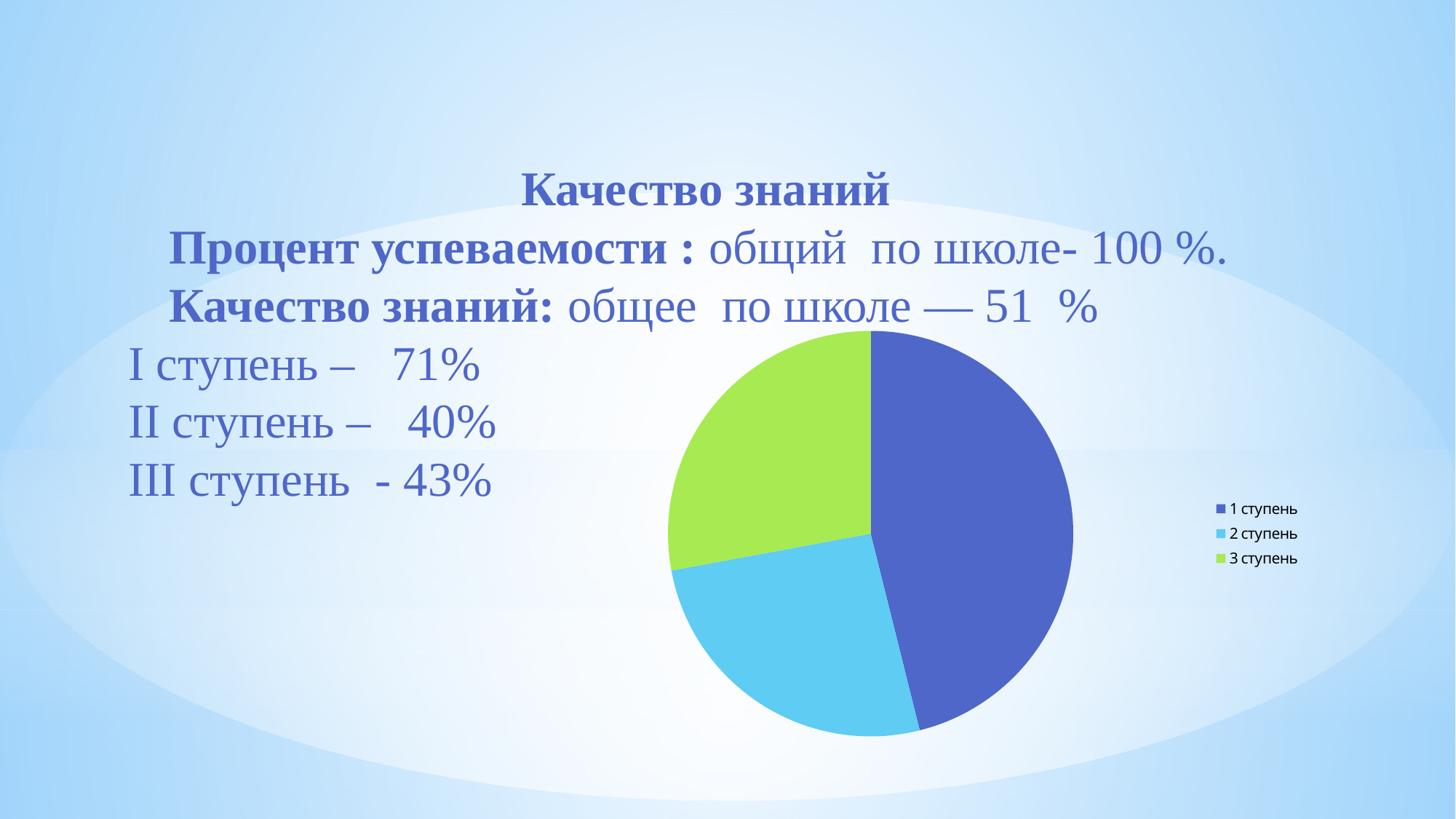
What colour is the slice for 1 ступень in the pie chart? dark blue What kind of chart is shown on the slide? pie chart Which slice is larger in the pie chart, 1 ступень or 2 ступень? 1 ступень How many slices does the pie chart have? 3 What colour is the slice for 3 ступень in the pie chart? green How many entries does the legend of the pie chart list? 3 Which slice is larger in the pie chart, 1 ступень or 3 ступень? 1 ступень Which category has the largest slice in the pie chart? 1 ступень